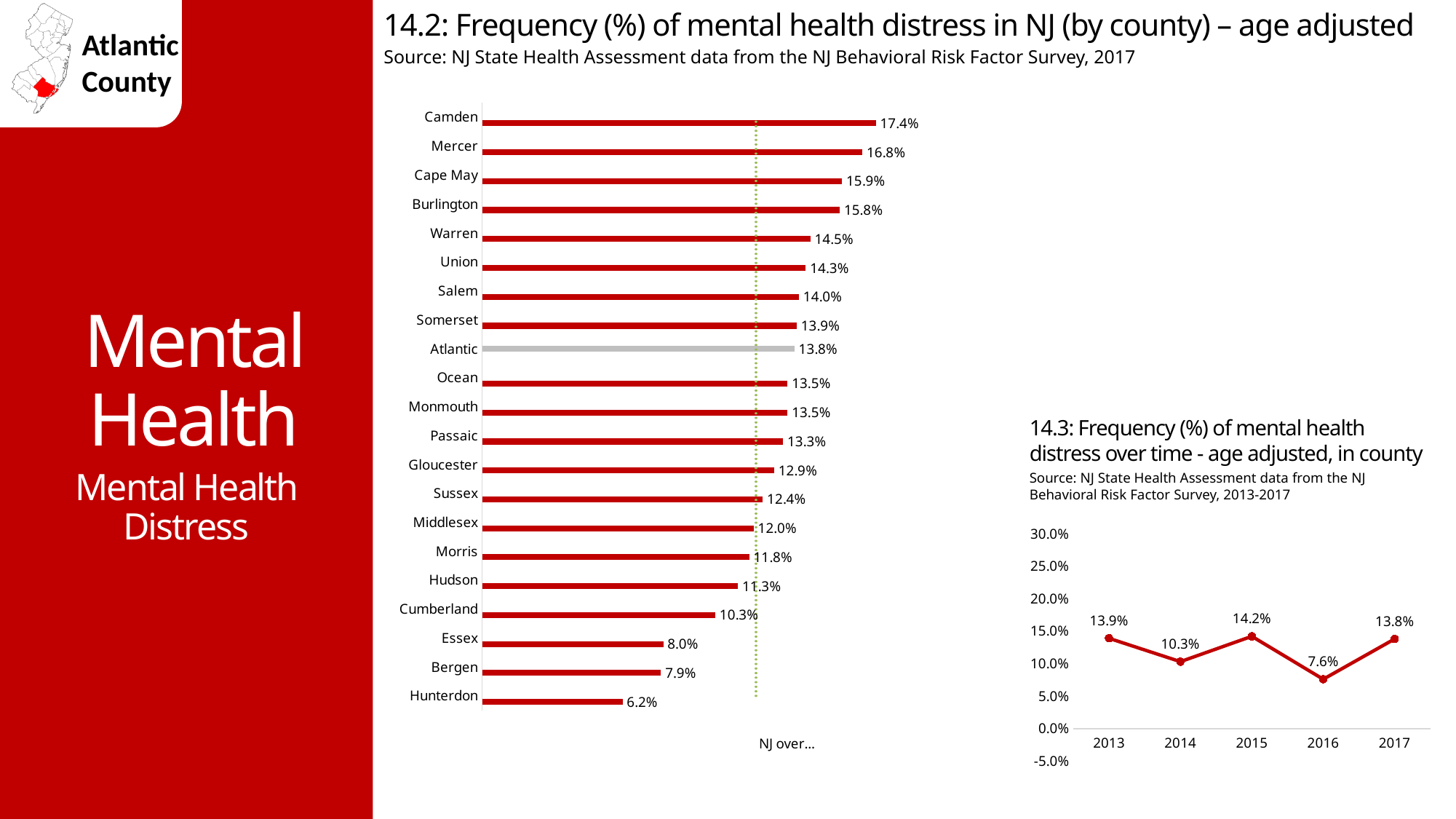
In chart 14.3, what is the value for 2016? 7.6% What kind of chart is chart 14.2? Bar chart In chart 14.3, which year has the highest value? 2015 In chart 14.2, how many counties are plotted? 21 In chart 14.3, what is the difference between the values for 2015 and 2016? 6.6% What kind of chart is chart 14.3? Line chart In chart 14.2, which county has the lowest frequency of mental health distress? Hunterdon In chart 14.2, what is the value for Atlantic county? 13.8% In chart 14.2, which county has the highest frequency of mental health distress? Camden In chart 14.2, what is the value for Cumberland? 10.3% In chart 14.2, which county has a larger value, Mercer or Cape May? Mercer In chart 14.2, what is the difference between the values for Camden and Hunterdon? 11.2%